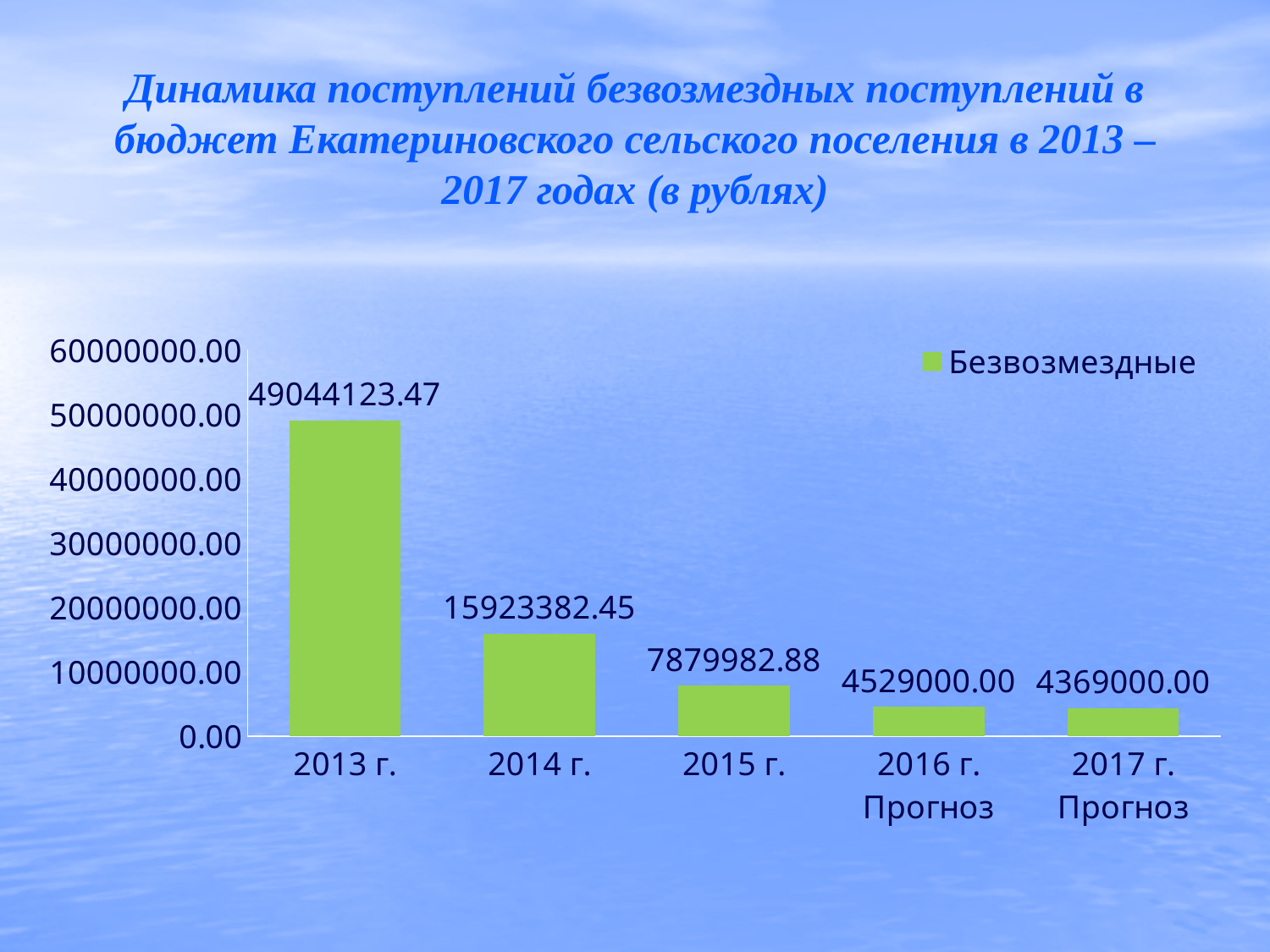
What is the value for 2015 г.? 7879982.88 Which year has the highest value? 2013 г. Is the value for 2014 г. greater or less than 20000000.00? less What kind of chart is shown on the slide? bar chart What is the difference between the values for 2013 г. and 2014 г.? 33120741.02 Do the values rise or fall from 2013 г. to 2017 г. Прогноз? fall What is the value for 2013 г.? 49044123.47 Which is larger, the value for 2014 г. or the value for 2015 г.? 2014 г. Which category has the lowest value? 2017 г. Прогноз How many categories are shown on the x axis? 5 What is the difference between the values for 2016 г. Прогноз and 2017 г. Прогноз? 160000.00 What is the value for 2017 г. Прогноз? 4369000.00